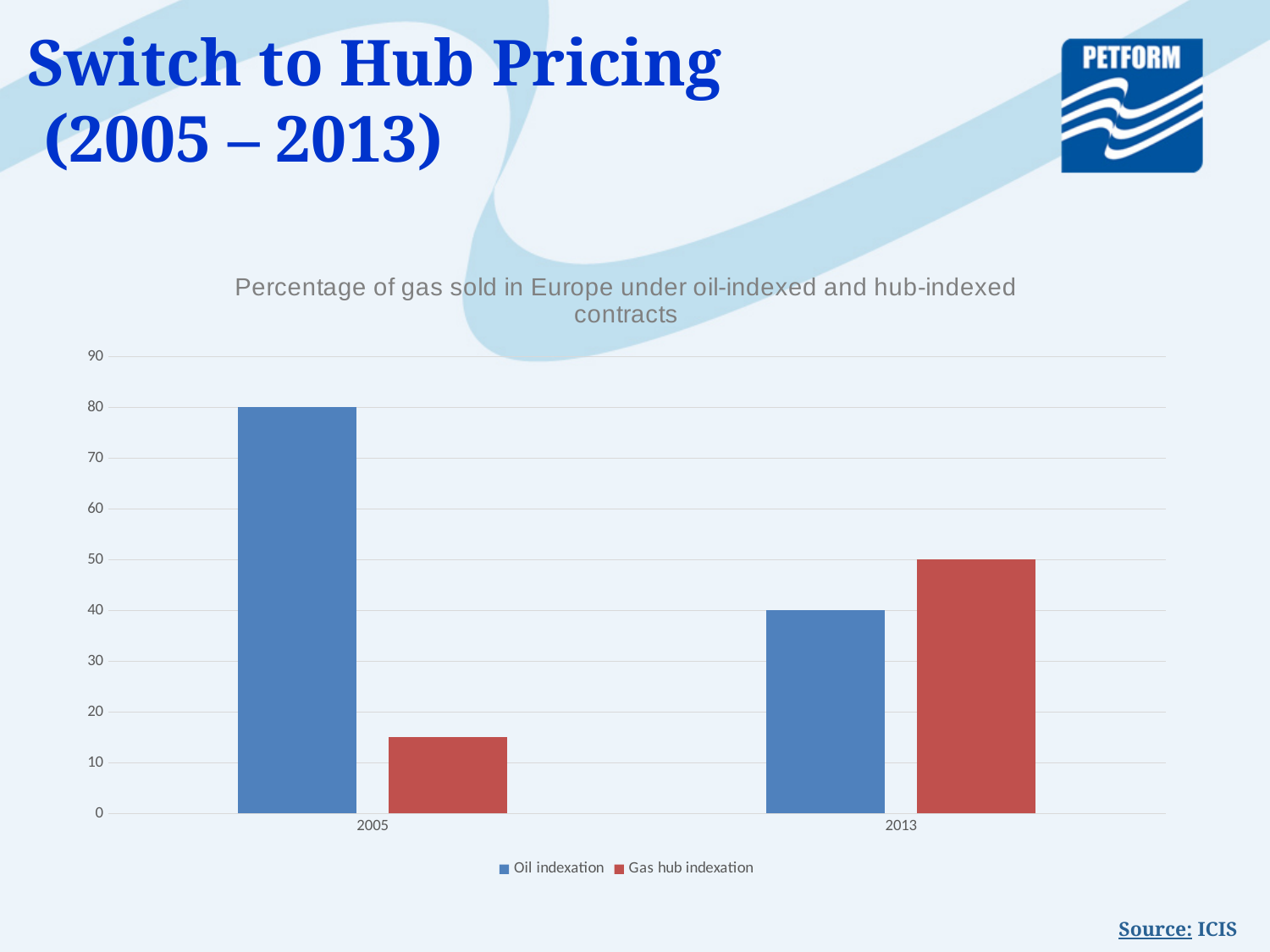
What is the value for Oil indexation in 2013? 40 Which series has the higher value in 2013, Oil indexation or Gas hub indexation? Gas hub indexation What is the value for Gas hub indexation in 2013? 50 What is the difference between Gas hub indexation and Oil indexation in 2013? 10 Which series has the higher value in 2005, Oil indexation or Gas hub indexation? Oil indexation Is the value for Gas hub indexation in 2005 greater or less than 10? greater By how much did Oil indexation fall from 2005 to 2013? 40 What is the value for Oil indexation in 2005? 80 How many series does the legend list? 2 Is the value for Gas hub indexation in 2005 greater or less than 20? less Does Gas hub indexation rise or fall from 2005 to 2013? rise What type of chart is shown on the slide? bar chart